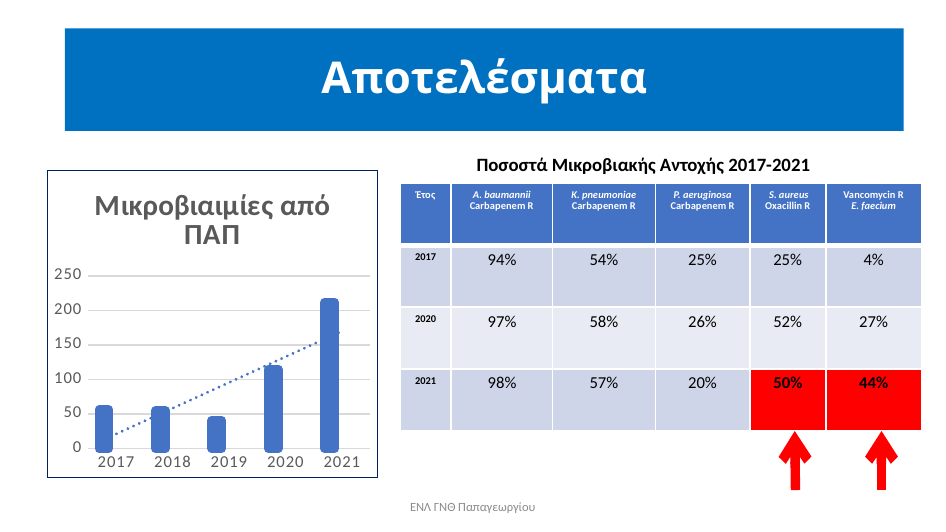
How many years are plotted on the x axis of the chart? 5 Which year has the lowest bar in the chart? 2019 Is the value for 2020 greater or less than 100? greater Do the values rise or fall from 2019 to 2021? rise Is the value for 2021 greater or less than 200? greater Is the value for 2019 greater or less than 50? less Which year has the larger value, 2019 or 2020? 2020 What kind of chart is shown on the slide? bar chart Which year has the highest bar in the chart? 2021 What is the title of the chart on the slide? Μικροβιαιμίες από ΠΑΠ Which year has the larger value, 2020 or 2021? 2021